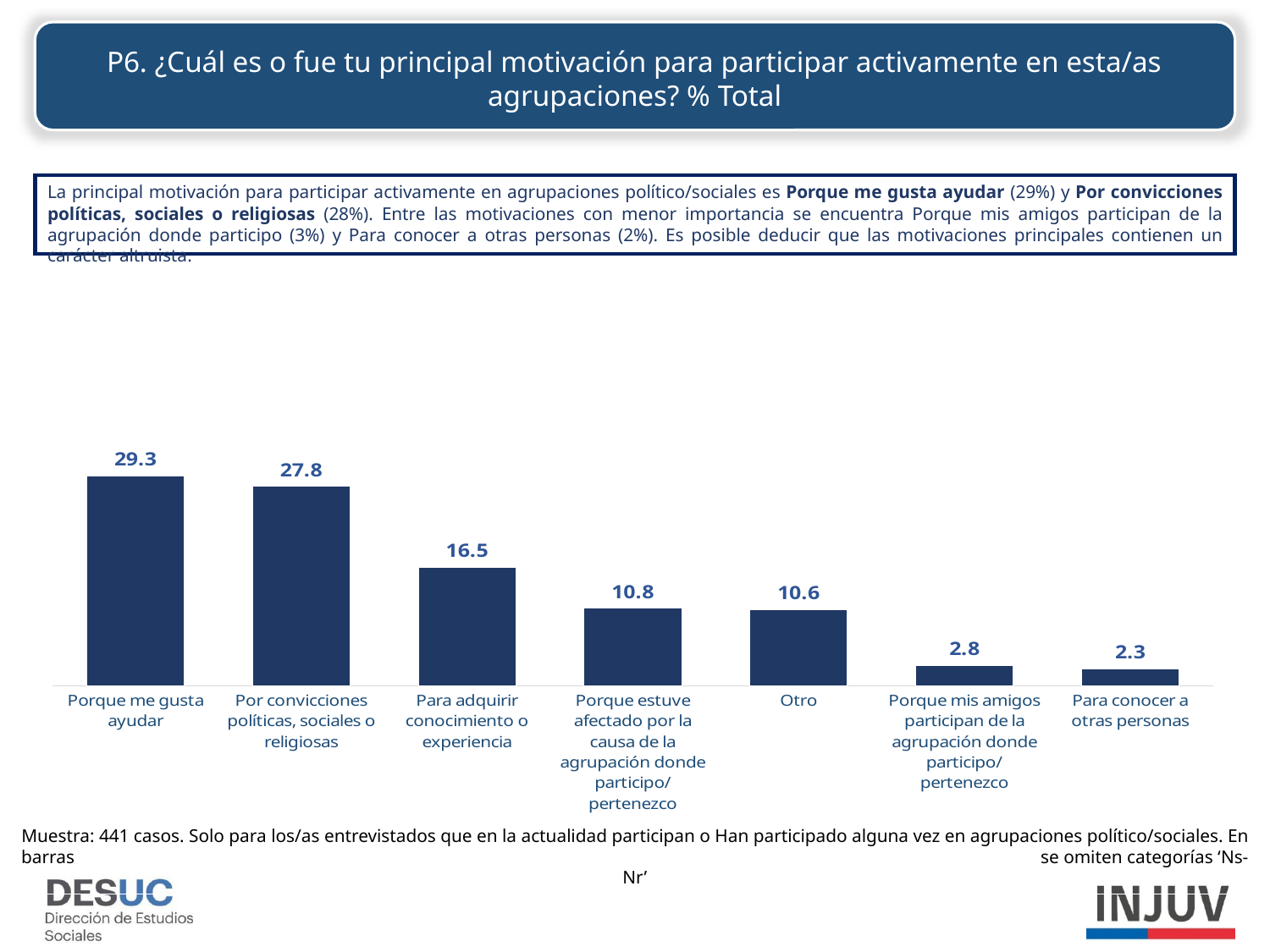
Which is larger, the value for "Para adquirir conocimiento o experiencia" or the value for "Otro"? Para adquirir conocimiento o experiencia Which category has the highest value? Porque me gusta ayudar What is the difference between the values for "Porque me gusta ayudar" and "Por convicciones políticas, sociales o religiosas"? 1.5 What is the difference between the values for "Para adquirir conocimiento o experiencia" and "Porque mis amigos participan de la agrupación donde participo/pertenezco"? 13.7 What kind of chart is shown on the slide? Bar chart What is the value for "Para conocer a otras personas"? 2.3 How many categories are shown in the chart? 7 Which category has the lowest value? Para conocer a otras personas What is the value for "Para adquirir conocimiento o experiencia"? 16.5 Do the values rise or fall from left to right across the categories? Fall What is the value for "Porque me gusta ayudar"? 29.3 What is the value for "Otro"? 10.6